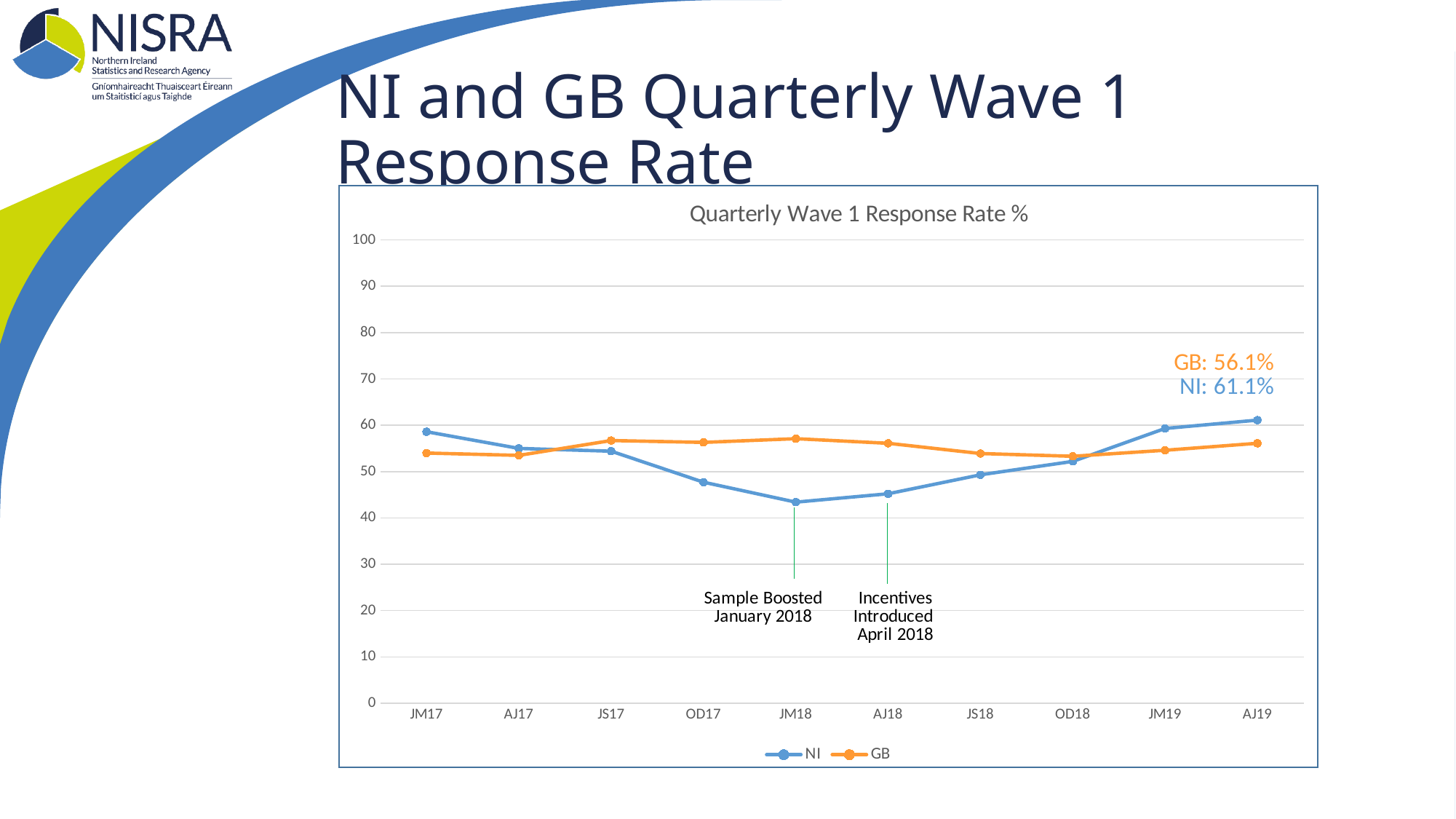
How many quarters are plotted on the x axis? 10 What is the NI response rate shown for AJ19? 61.1% What is the GB response rate shown for AJ19? 56.1% How many series does the legend list? 2 At JM18, which series has the higher response rate, NI or GB? GB At AJ19, which series has the higher response rate, NI or GB? NI Is the NI value for JM18 greater or less than 50? less Does the NI series rise or fall from JM18 to AJ19? Rise What is the difference between the NI and GB response rates at AJ19? 5.0% At which quarter does the NI series reach its lowest point? JM18 Is the GB value for JM18 greater or less than 50? greater What kind of chart is shown on the slide? Line chart